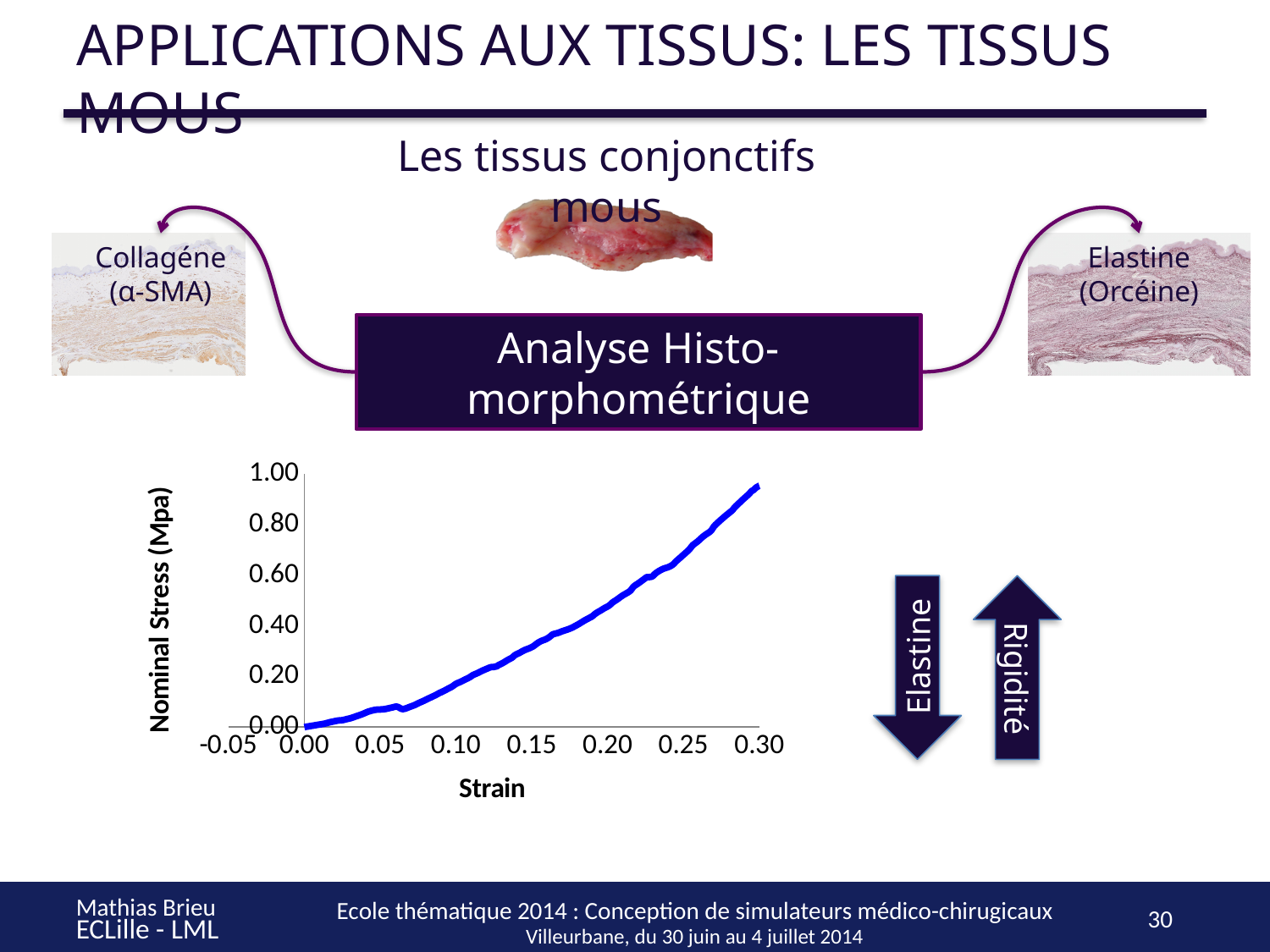
What kind of chart is shown on the slide? line chart Which has the larger nominal stress: a strain of 0.10 or a strain of 0.20? 0.20 Is the nominal stress at a strain of 0.25 greater or less than 0.80? less Does the nominal stress rise or fall as strain increases along the x axis? rise Is the nominal stress at a strain of 0.25 greater or less than 0.60? greater Is the nominal stress at a strain of 0.30 greater or less than 0.80? greater What is the label of the y axis of the chart? Nominal Stress (Mpa) What is the label of the x axis of the chart? Strain At which strain value on the x axis is the nominal stress highest? 0.30